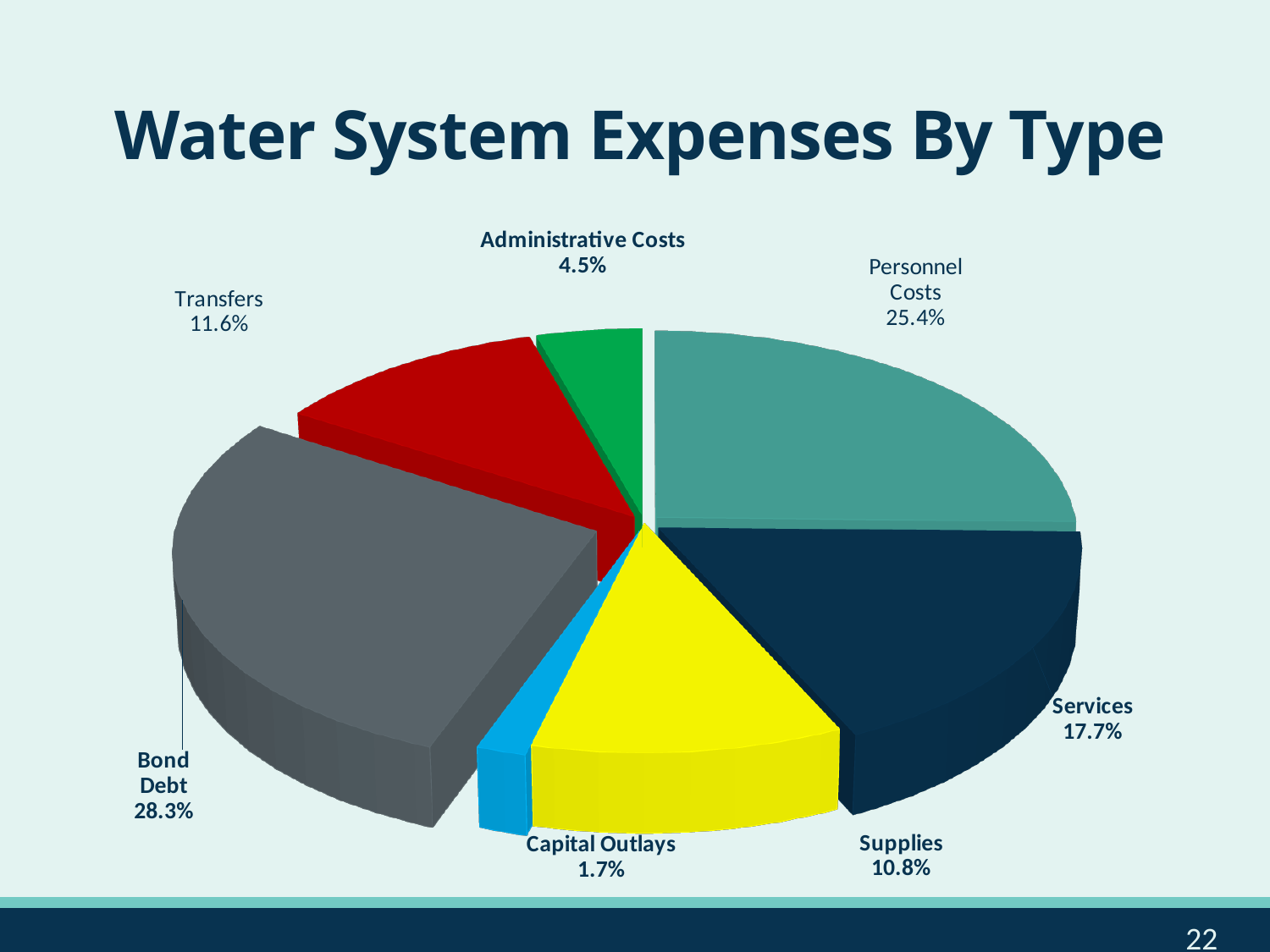
Which is larger, Transfers or Supplies? Transfers What kind of chart is shown on the slide? Pie chart Which expense type has the largest share of the pie? Bond Debt What is the difference in percentage points between Services and Supplies? 6.9 What colour is the Bond Debt slice? Grey What is the title of the chart? Water System Expenses By Type What share of water system expenses is Bond Debt? 28.3% Which expense type has the smallest share of the pie? Capital Outlays What share of water system expenses is Capital Outlays? 1.7% What share of water system expenses is Personnel Costs? 25.4% How many expense types are shown in the pie chart? 7 What share of water system expenses is Transfers? 11.6%